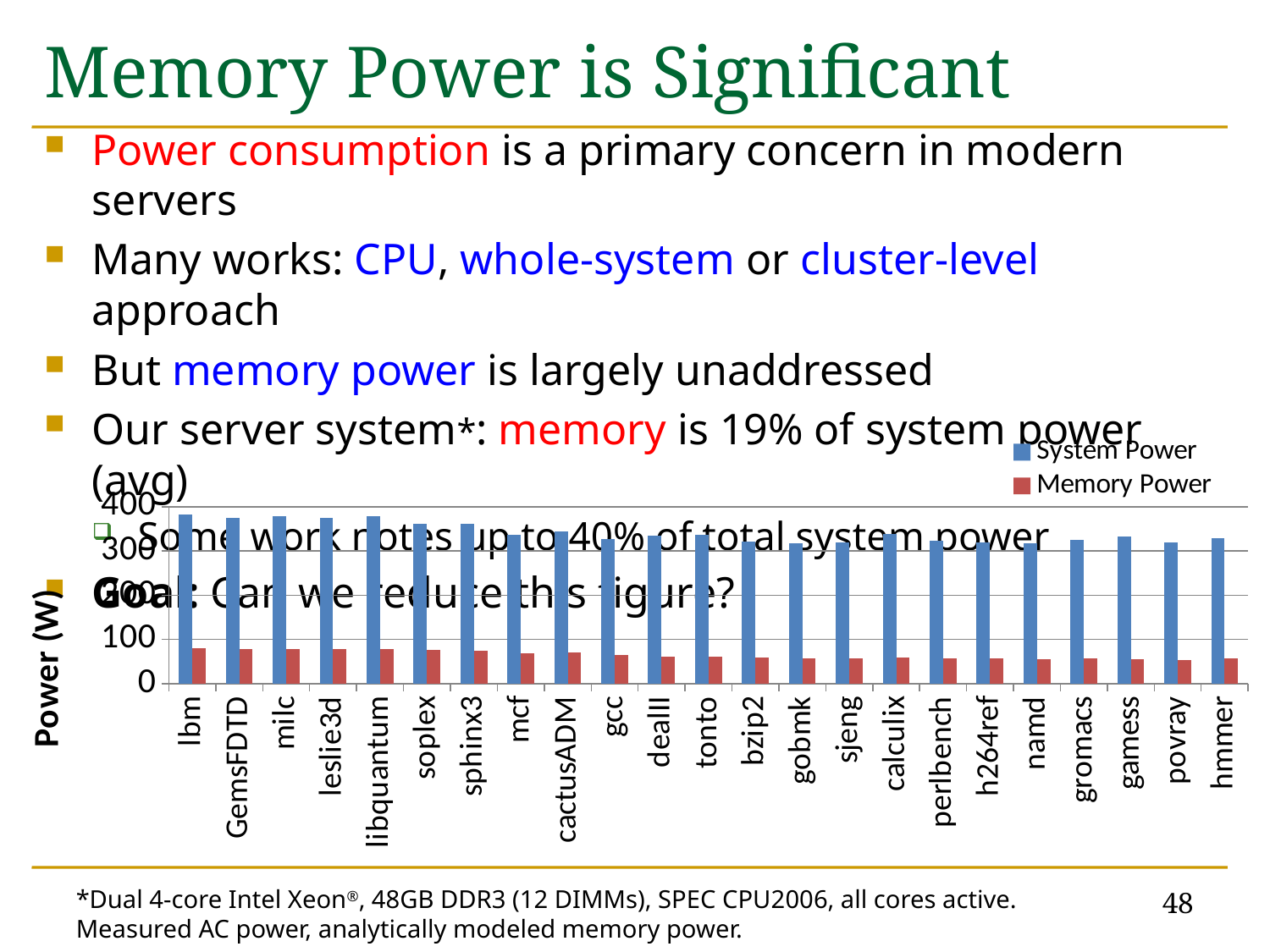
What kind of chart is shown on the slide? bar chart Is the Memory Power value for hmmer greater or less than 100? less Is the System Power value for lbm greater or less than 300? greater Does the Memory Power series generally rise or fall moving from left to right along the x axis? fall How many benchmark categories are plotted along the x axis of the chart? 23 Which has the larger Memory Power value, lbm or hmmer? lbm Which has the larger System Power value, lbm or povray? lbm Is the System Power value for gobmk greater or less than 200? greater What is the label on the chart's y axis? Power (W) How many series does the chart's legend list? 2